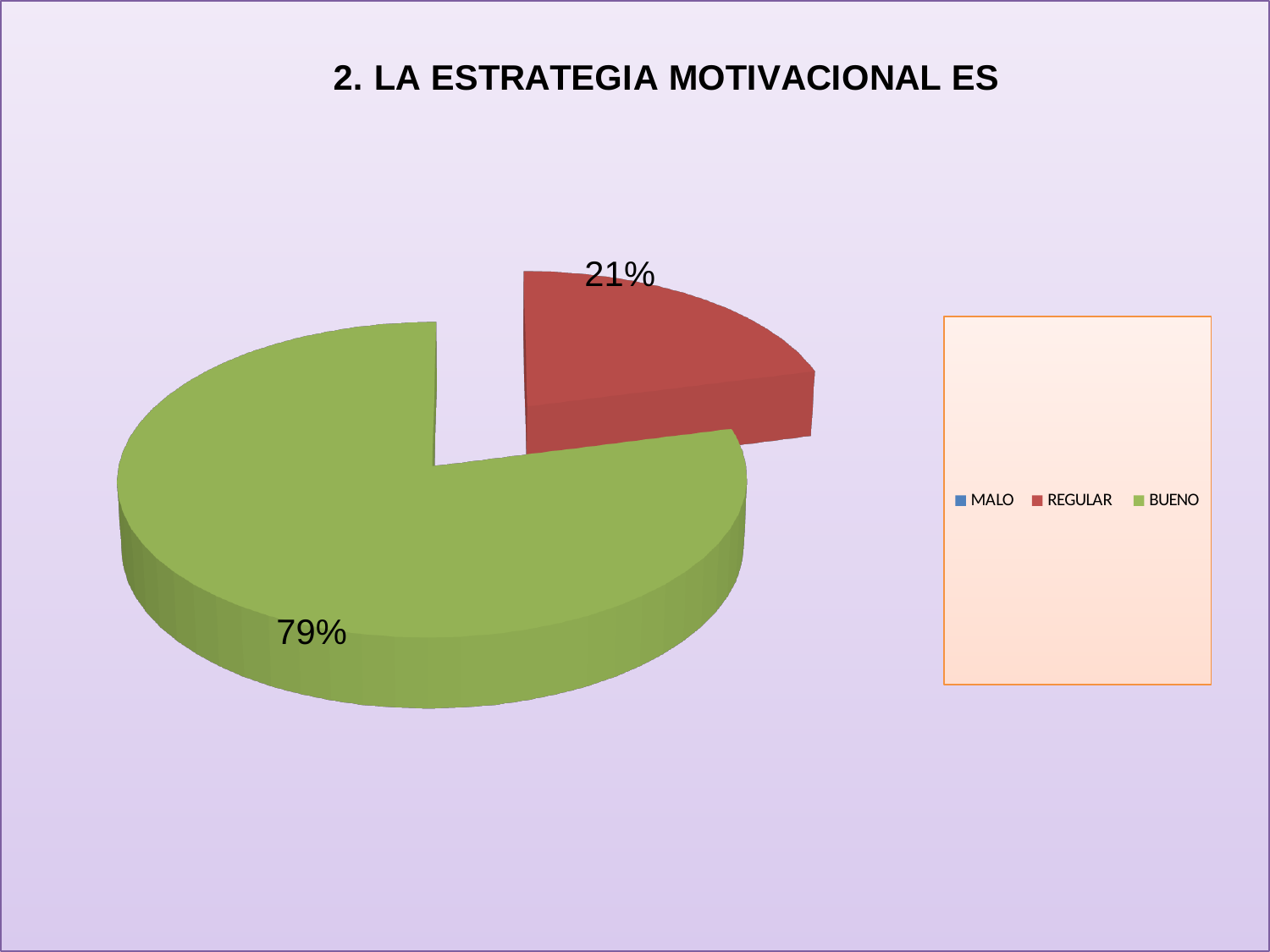
What share of the pie does REGULAR represent? 21% How many categories does the legend list? 3 What is the title of the chart? 2. LA ESTRATEGIA MOTIVACIONAL ES Which category has the largest slice of the pie? BUENO Which of the visible slices is smaller, REGULAR or BUENO? REGULAR Is the share for BUENO greater or less than 50%? greater What share of the pie does BUENO represent? 79% What is the difference in percentage points between the BUENO and REGULAR slices? 58 What kind of chart is shown on the slide? Pie chart Is the share for REGULAR greater or less than 25%? less What colour is the BUENO slice? Green